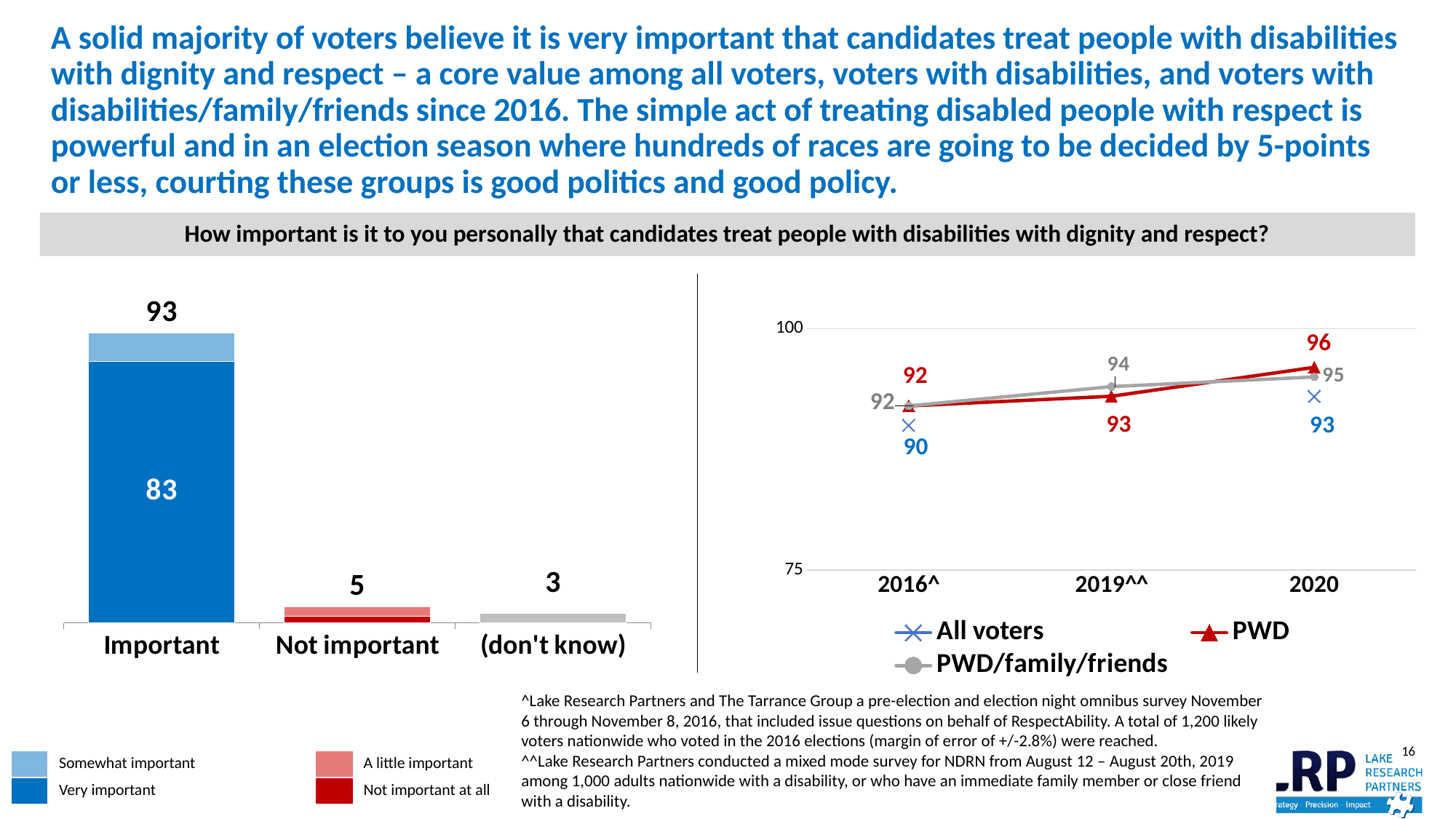
In the right line chart, how many series does the legend list? 3 In the left bar chart, what is the total value shown for the Important bar? 93 In the right line chart, what is the value for PWD in 2020? 96 In the left bar chart, what is the value shown for (don't know)? 3 In the left bar chart, which category has the lowest value? (don't know) In the right line chart, does the PWD series rise or fall from 2016^ to 2020? Rise What kind of chart is on the right side of the slide? Line chart In the right line chart, what is the value for PWD/family/friends in 2019^^? 94 In the left bar chart, what is the value shown for Not important? 5 In the left bar chart, what is the difference between the Important total and the Not important value? 88 In the left bar chart, what is the value of the Very important segment of the Important bar? 83 In the right line chart, what is the value for All voters in 2016^? 90